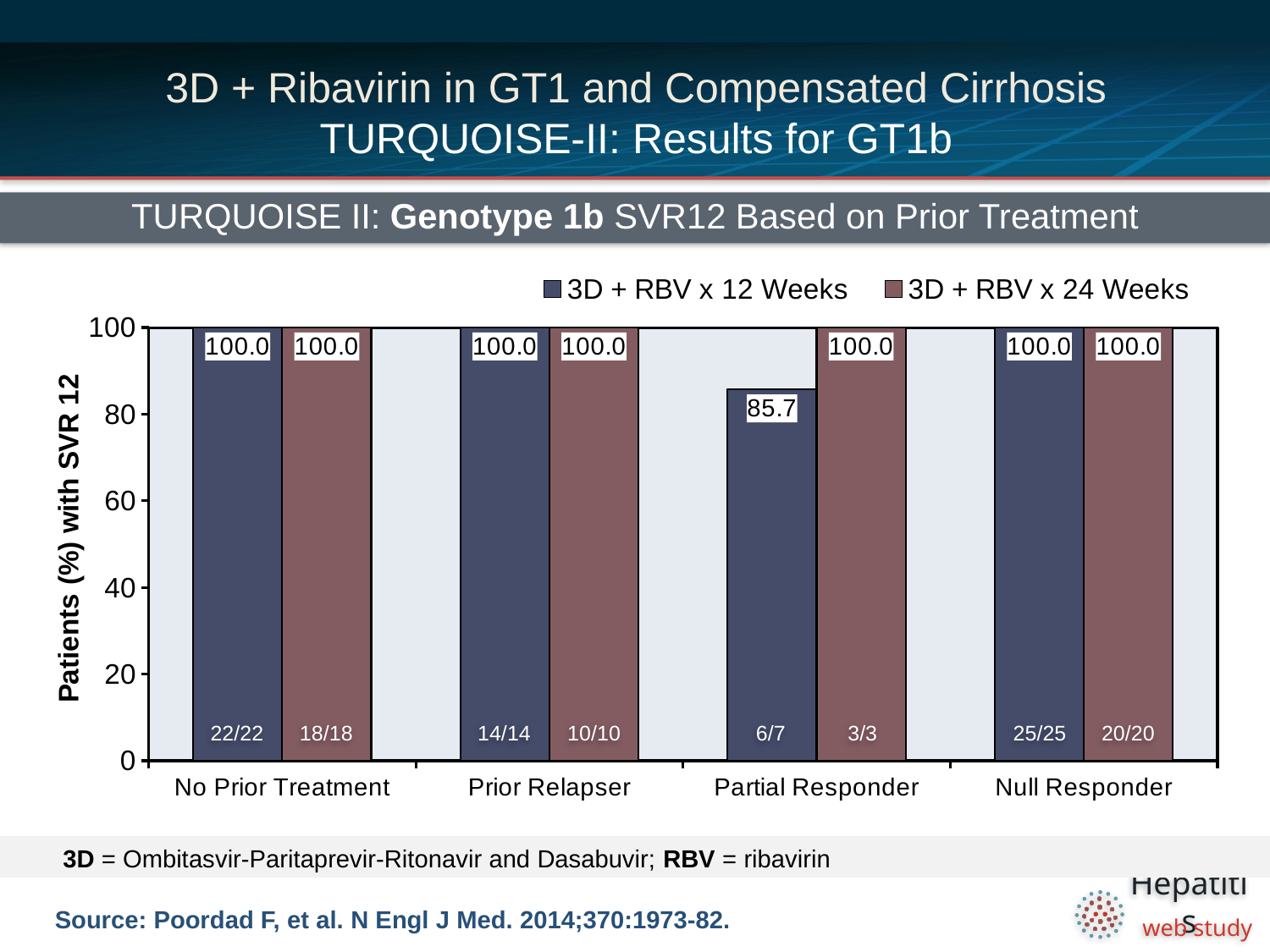
How many series does the legend list? 2 What fraction of patients is shown for No Prior Treatment in the 3D + RBV x 12 Weeks series? 22/22 For Partial Responder, which series has the larger value, 3D + RBV x 12 Weeks or 3D + RBV x 24 Weeks? 3D + RBV x 24 Weeks How many categories are shown on the x axis? 4 Is the value for Partial Responder in the 3D + RBV x 12 Weeks series greater or less than 80? greater What kind of chart is shown on the slide? bar chart What is the label of the y axis? Patients (%) with SVR 12 Which category has the lowest value in the 3D + RBV x 12 Weeks series? Partial Responder What is the SVR12 value for Partial Responder in the 3D + RBV x 12 Weeks series? 85.7 What fraction of patients is shown for Partial Responder in the 3D + RBV x 24 Weeks series? 3/3 What is the SVR12 value for Null Responder in the 3D + RBV x 24 Weeks series? 100.0 What is the difference between the 3D + RBV x 24 Weeks and 3D + RBV x 12 Weeks values for Partial Responder? 14.3